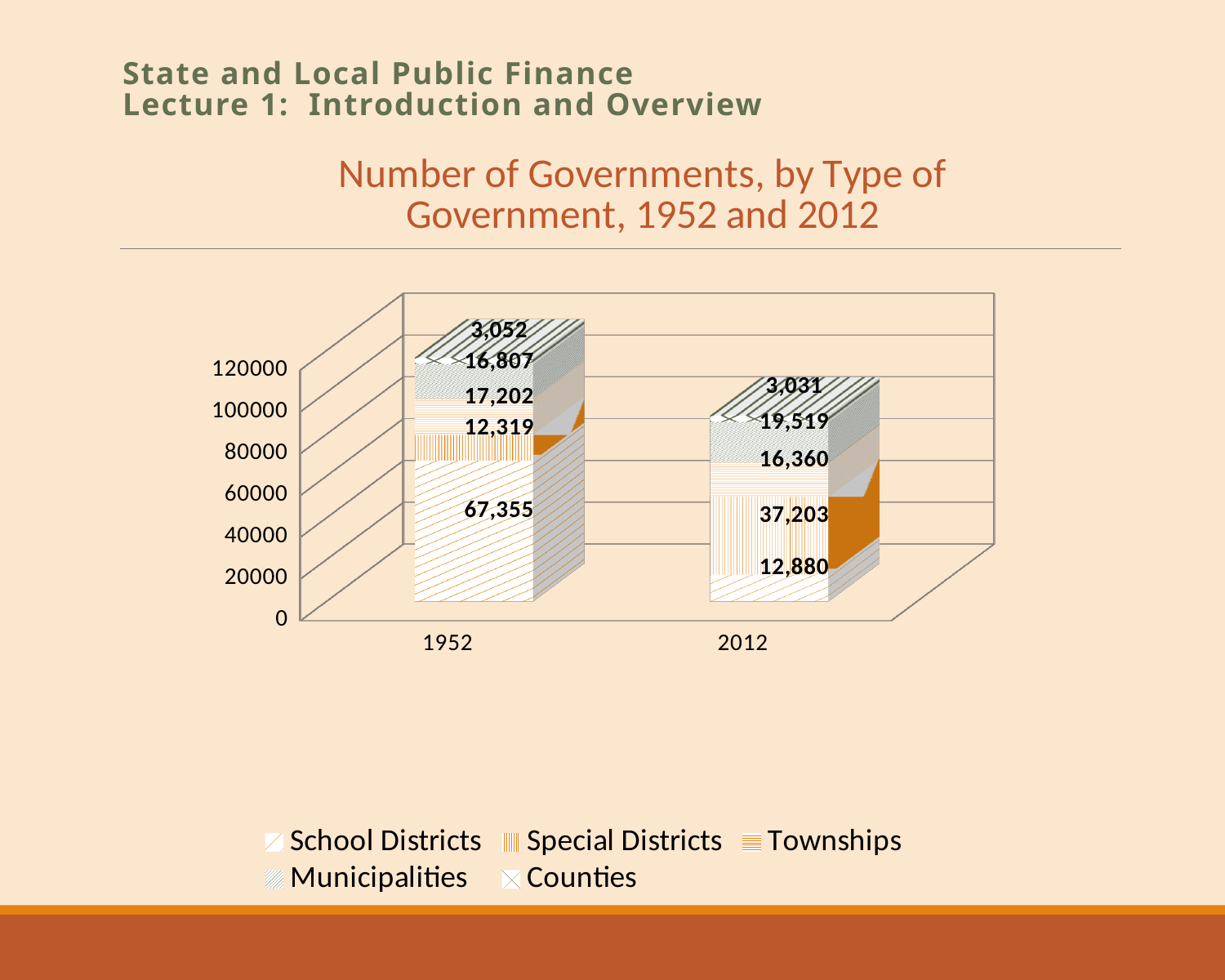
What is the number of Townships in 1952? 17,202 Which type of government has the smallest value in the 2012 bar? Counties What is the number of Counties in 2012? 3,031 What is the number of School Districts in 1952? 67,355 Which type of government has the largest value in the 1952 bar? School Districts How many series does the legend list? 5 Which is larger: Municipalities in 1952 or Municipalities in 2012? Municipalities in 2012 How many categories (years) are shown on the x axis? 2 By how much did the number of School Districts fall from 1952 to 2012? 54,475 What type of chart is shown on the slide? stacked bar chart What is the total number of governments in the 2012 bar? 88,993 What is the number of Special Districts in 2012? 37,203